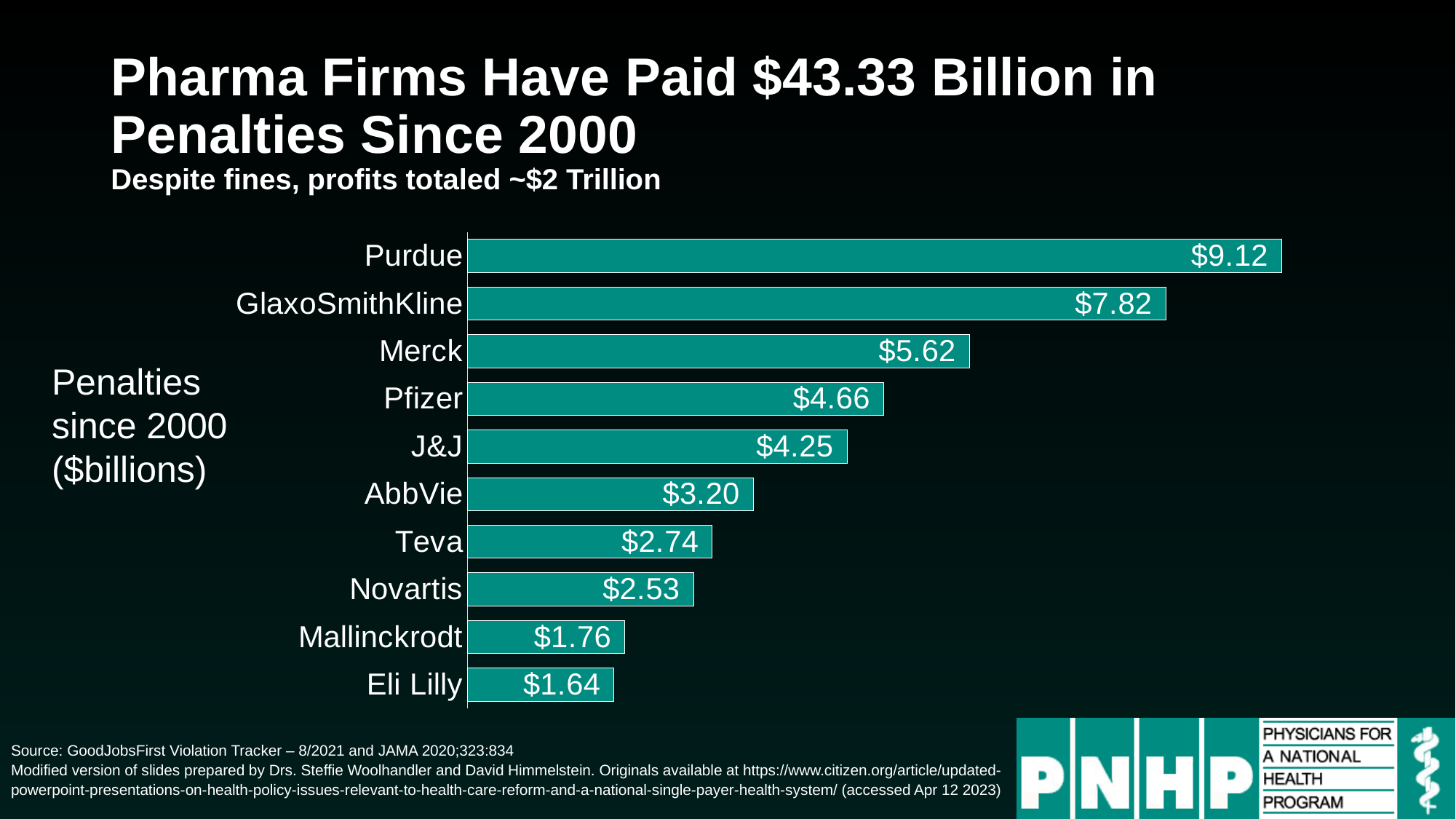
What is the value shown for Novartis? $2.53 Which company has the lowest penalties in the chart? Eli Lilly Which company has the highest penalties in the chart? Purdue What kind of chart is shown on the slide? Bar chart What unit is used for the values in the chart, according to the axis label? $billions What is the difference between the values for Merck and AbbVie? $2.42 What is the difference between the values for Purdue and GlaxoSmithKline? $1.30 Which is larger, the value for J&J or the value for Teva? J&J How many companies are shown in the chart? 10 What is the value shown for Purdue? $9.12 What is the title of the slide? Pharma Firms Have Paid $43.33 Billion in Penalties Since 2000 What is the value shown for Pfizer? $4.66